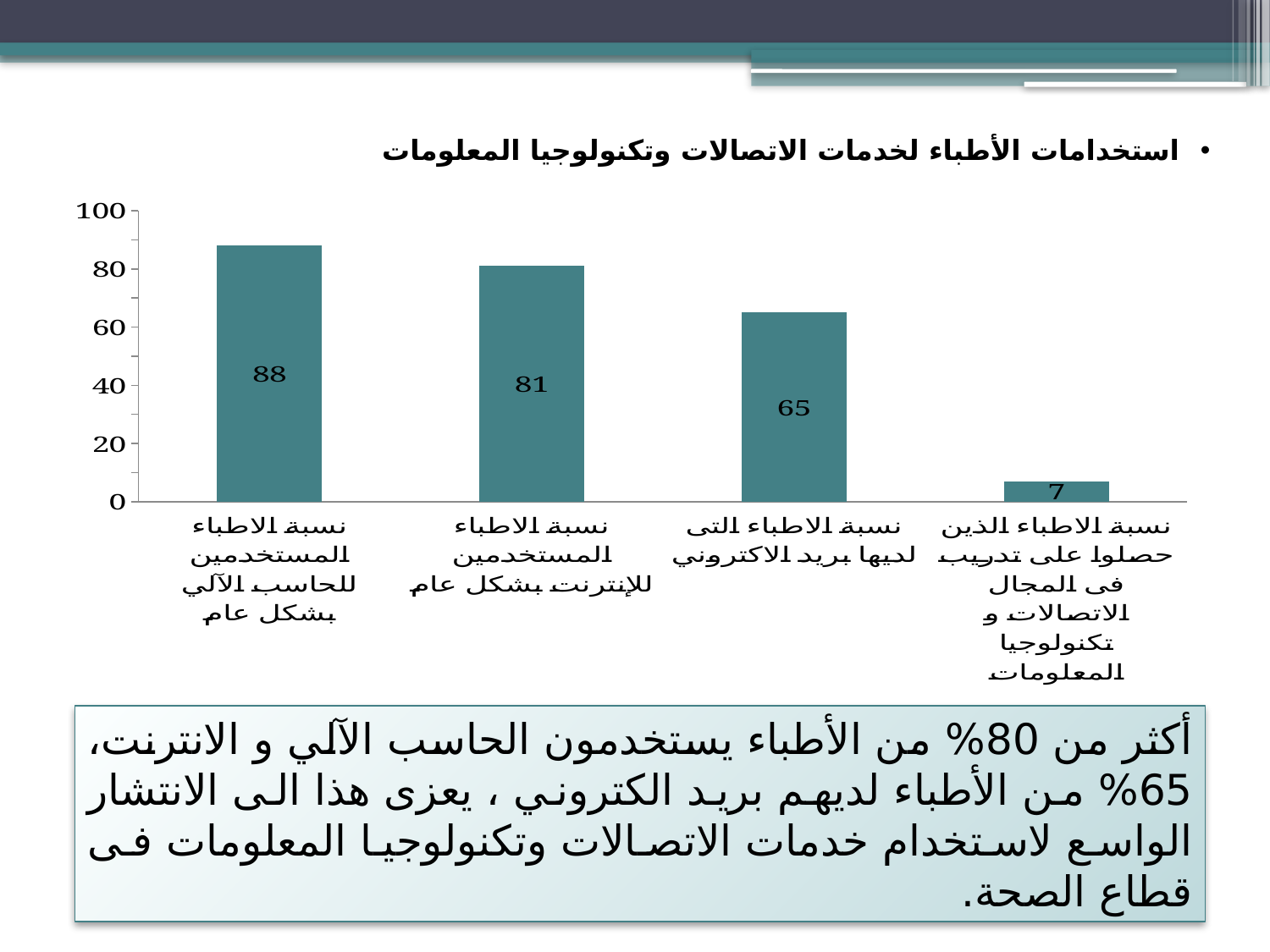
Which is larger: the value for نسبة الاطباء المستخدمين للإنترنت بشكل عام or the value for نسبة الاطباء التي لديها بريد الاكتروني? نسبة الاطباء المستخدمين للإنترنت بشكل عام What is the difference between the value for نسبة الاطباء المستخدمين للحاسب الآلي بشكل عام and the value for نسبة الاطباء المستخدمين للإنترنت بشكل عام? 7 What is the value for نسبة الاطباء التي لديها بريد الاكتروني? 65 What is the value for نسبة الاطباء الذين حصلوا على تدريب في المجال الاتصالات و تكنولوجيا المعلومات? 7 What is the value for نسبة الاطباء المستخدمين للإنترنت بشكل عام? 81 Which category has the lowest value? نسبة الاطباء الذين حصلوا على تدريب في المجال الاتصالات و تكنولوجيا المعلومات What is the value for نسبة الاطباء المستخدمين للحاسب الآلي بشكل عام? 88 Do the values rise or fall from left to right across the categories? Fall What kind of chart is shown on the slide? Bar chart Which category has the highest value? نسبة الاطباء المستخدمين للحاسب الآلي بشكل عام What is the difference between the value for نسبة الاطباء التي لديها بريد الاكتروني and the value for نسبة الاطباء الذين حصلوا على تدريب في المجال الاتصالات و تكنولوجيا المعلومات? 58 How many categories are shown in the chart? 4